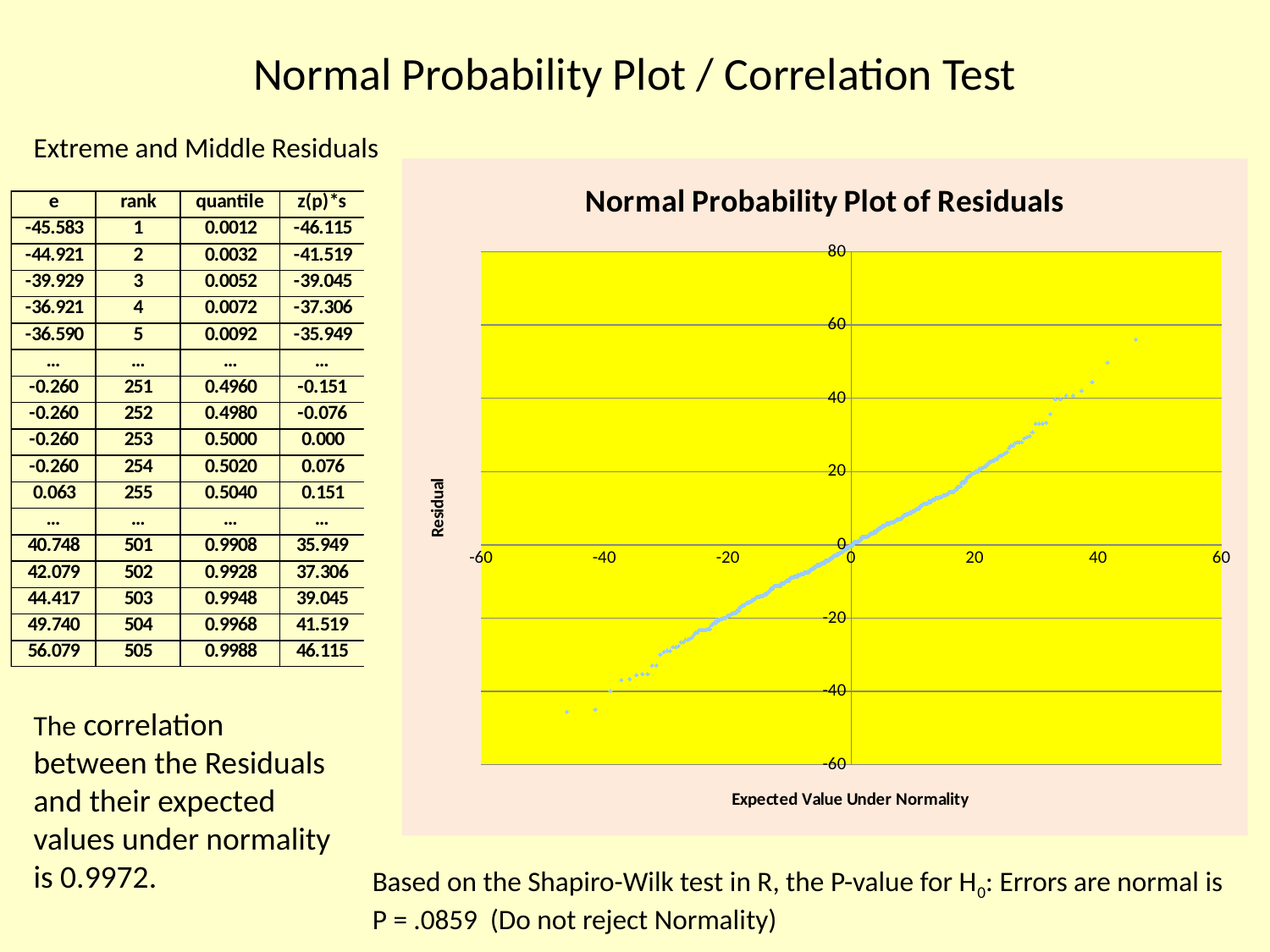
What is the label of the horizontal axis of the Normal Probability Plot of Residuals? Expected Value Under Normality In the Normal Probability Plot of Residuals, is the expected value under normality of the lowest point greater or less than -40? less What is the title of the chart on the slide? Normal Probability Plot of Residuals In the Normal Probability Plot of Residuals, do the residuals rise or fall as the expected value under normality increases? rise In the Normal Probability Plot of Residuals, is the residual of the lowest point greater or less than -40? less How many residuals are plotted in the Normal Probability Plot of Residuals, according to the ranks in the table? 505 What kind of chart is the Normal Probability Plot of Residuals? scatter plot In the Normal Probability Plot of Residuals, is the residual of the highest point greater or less than 60? less